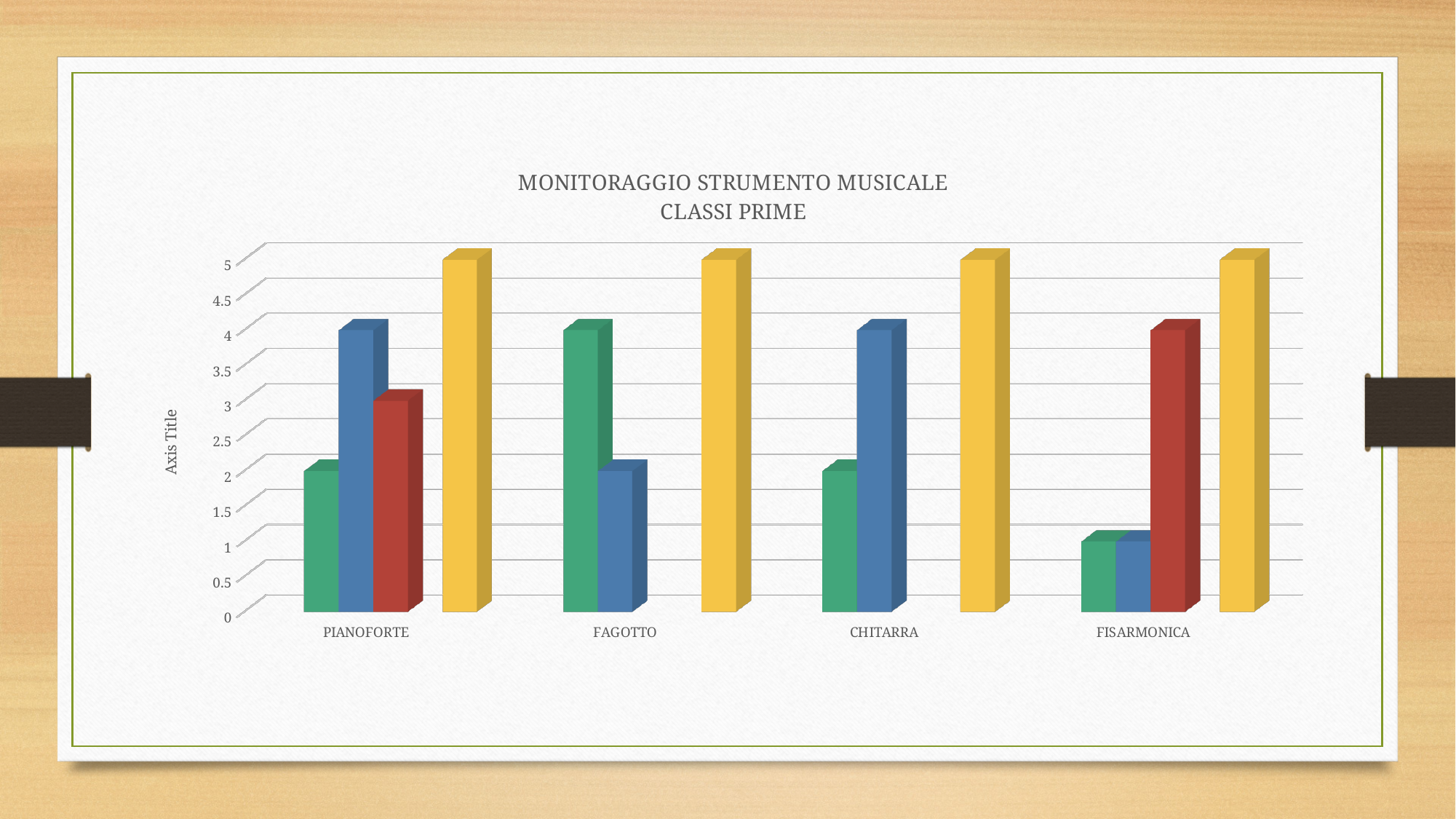
What is the value of the green bar for FAGOTTO? 4 Is the value of the green bar for FISARMONICA greater or less than 2? less What is the title of the chart? MONITORAGGIO STRUMENTO MUSICALE CLASSI PRIME For PIANOFORTE, which is larger: the blue bar or the green bar? the blue bar Which category has the highest red bar? FISARMONICA What kind of chart is shown on the slide? bar chart How many instrument categories are shown on the x axis? 4 What is the label on the vertical axis? Axis Title Which category has the highest green bar? FAGOTTO Which category has the lowest green bar? FISARMONICA Is the value of the blue bar for CHITARRA greater or less than 3? greater